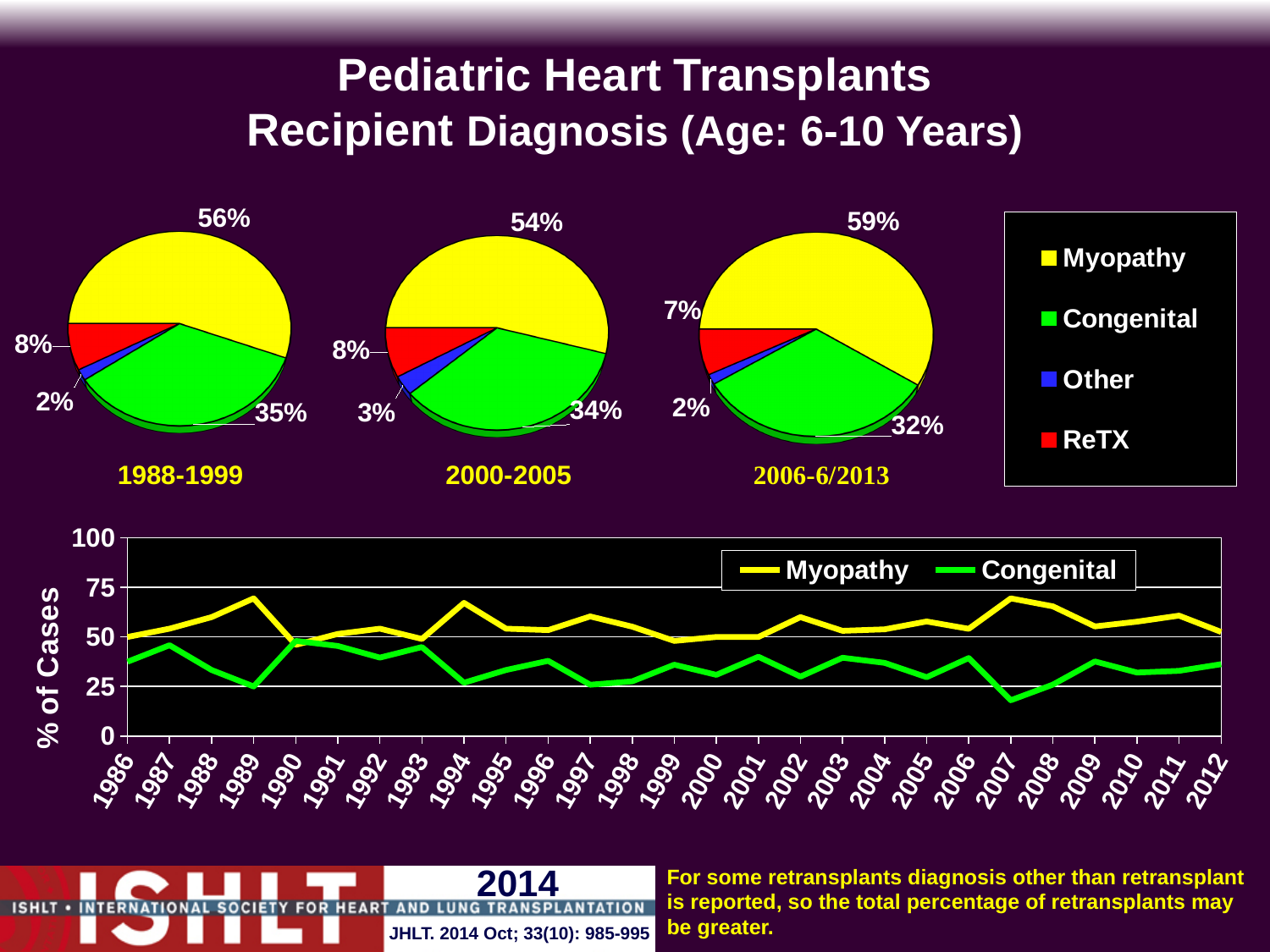
In the 1988-1999 pie chart, which diagnosis has the smallest share? Other In the 2006-6/2013 pie chart, what share of cases is ReTX? 7% Comparing the three pie charts, is the Myopathy share larger in 1988-1999 or in 2006-6/2013? 2006-6/2013 What kind of chart is the bottom chart showing % of Cases by year? Line chart In the bottom line chart, is the Congenital value for 2007 greater or less than 25? less In the 2000-2005 pie chart, what share of cases is Congenital? 34% In the 2000-2005 pie chart, what is the difference between the Myopathy share and the Congenital share? 20% In the bottom line chart, is the Myopathy value for 2007 greater or less than 50? greater In the 2006-6/2013 pie chart, which diagnosis has the largest share? Myopathy In the 1988-1999 pie chart, what share of cases is Myopathy? 56% How many diagnosis categories does the pie chart legend list? 4 In the bottom line chart, how many series does the legend list? 2